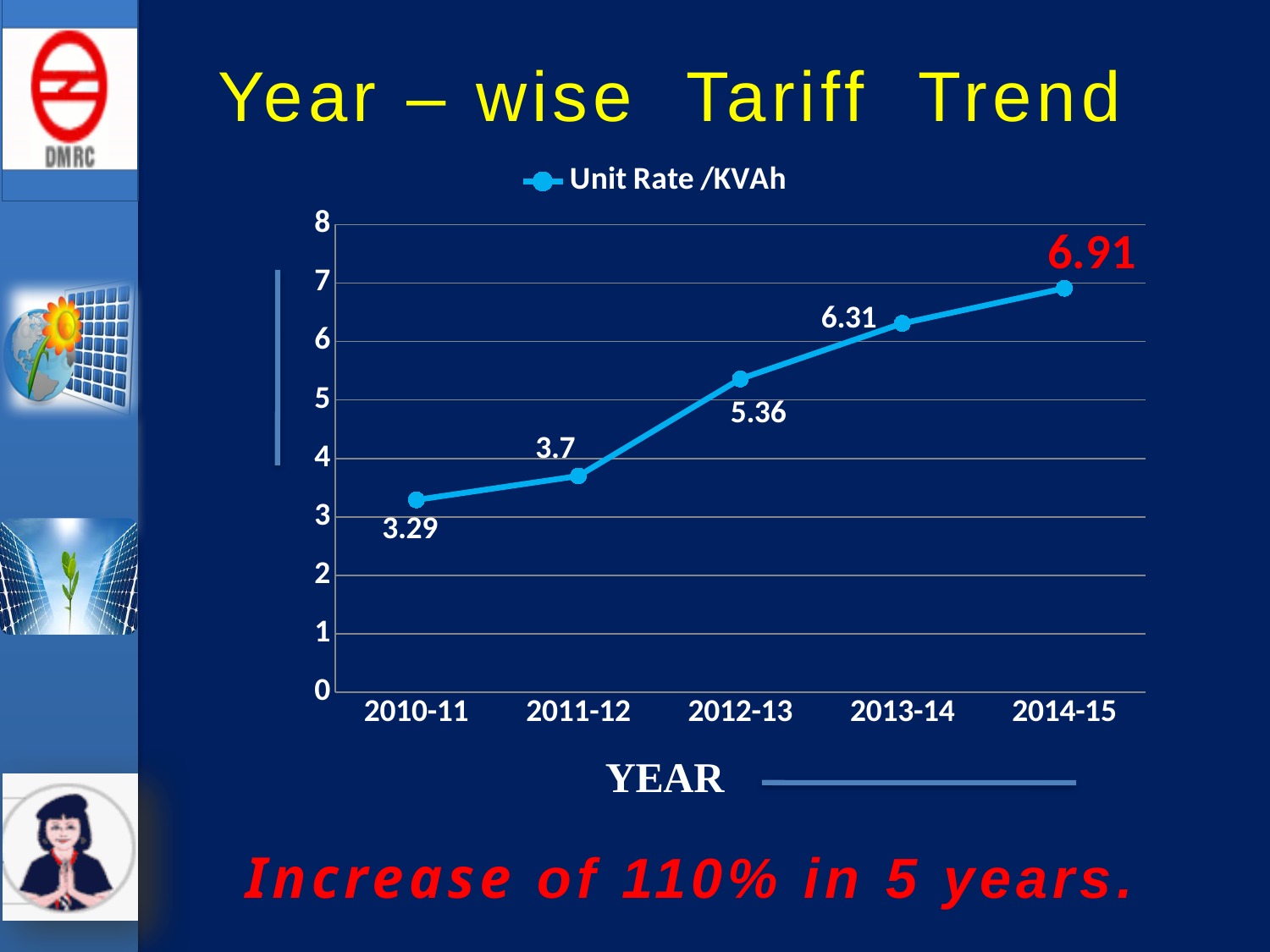
Which is larger, the Unit Rate /KVAh for 2011-12 or for 2012-13? 2012-13 What is the Unit Rate /KVAh for 2012-13? 5.36 Is the Unit Rate /KVAh for 2013-14 greater or less than 6? greater Does the Unit Rate /KVAh rise or fall from 2010-11 to 2014-15? rise How many series does the legend list? 1 How many years are plotted on the chart? 5 What is the Unit Rate /KVAh for 2014-15? 6.91 Which year has the lowest Unit Rate /KVAh? 2010-11 Which year has the highest Unit Rate /KVAh? 2014-15 What is the Unit Rate /KVAh for 2010-11? 3.29 What is the difference between the Unit Rate /KVAh in 2013-14 and 2012-13? 0.95 What kind of chart is shown on the slide? line chart